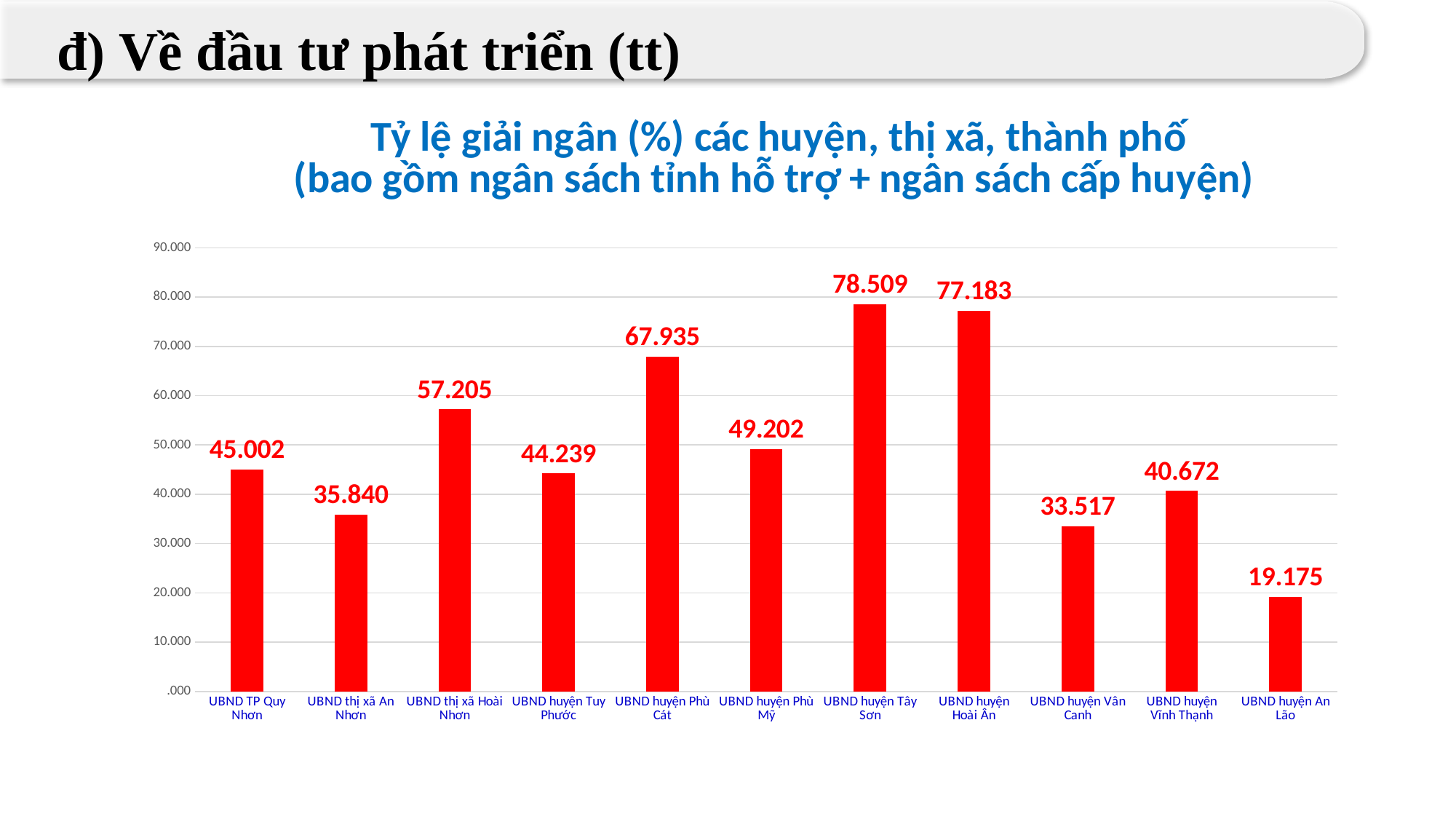
What is the value for UBND huyện Vĩnh Thạnh? 40.672 What is the difference between the values for UBND huyện Phù Cát and UBND huyện Phù Mỹ? 18.733 What is the difference between the values for UBND huyện Tây Sơn and UBND huyện An Lão? 59.334 Which category has the lowest value? UBND huyện An Lão How many categories are shown on the x axis? 11 What is the value for UBND thị xã An Nhơn? 35.840 Which is larger, the value for UBND TP Quy Nhơn or UBND huyện Tuy Phước? UBND TP Quy Nhơn Which category has the highest value? UBND huyện Tây Sơn What is the value for UBND huyện Phù Cát? 67.935 Is the value for UBND thị xã Hoài Nhơn greater or less than 50.000? greater What colour are the bars in the chart? red What kind of chart is shown on the slide? bar chart